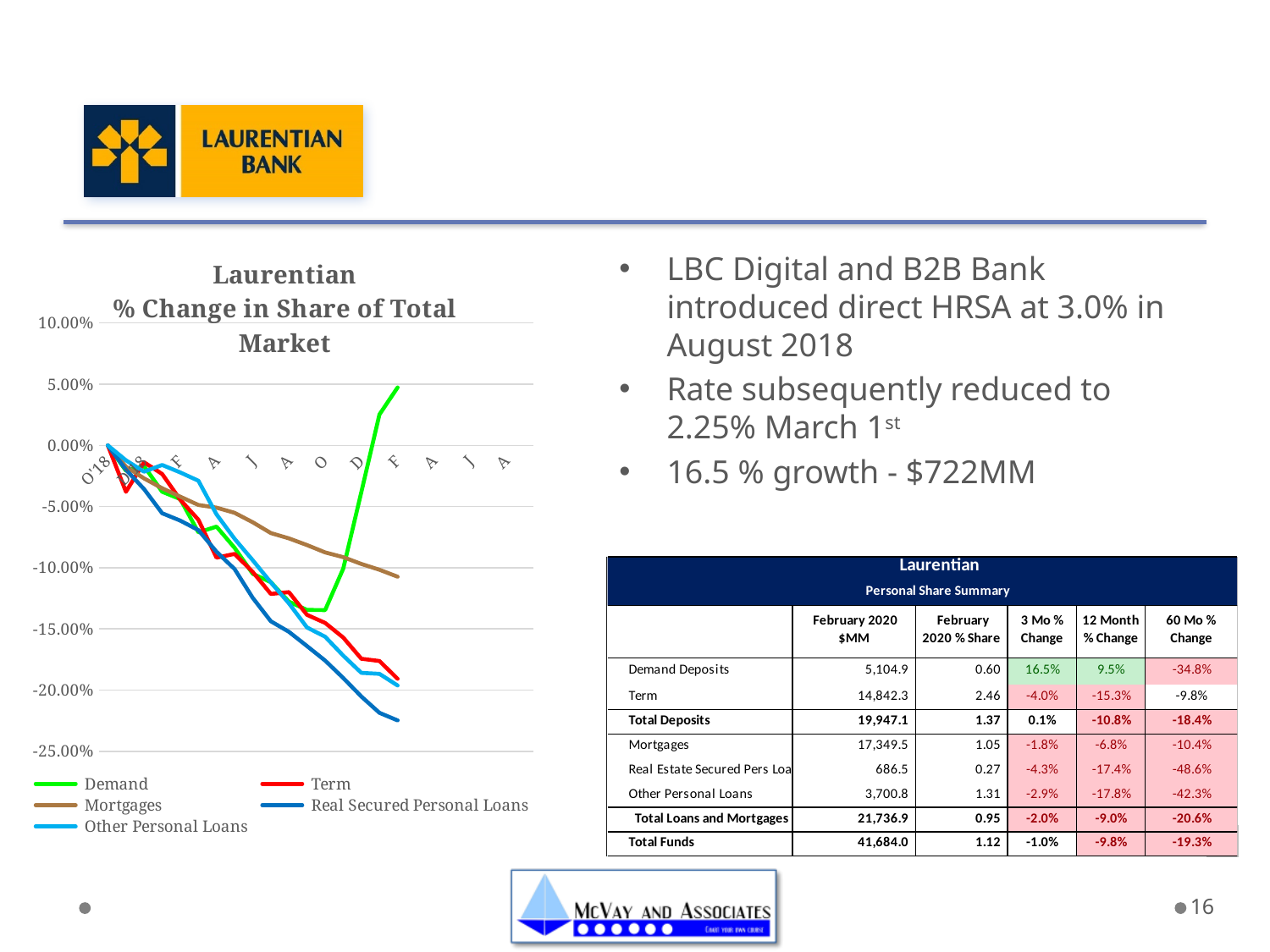
Which series has the highest value at the right end of the chart? Demand Is the final value of the Demand line greater or less than 0.00%? greater Is the final value of the Mortgages line greater or less than -5.00%? less Is the final value of the Real Secured Personal Loans line greater or less than -20.00%? less What kind of chart is shown on the slide? line chart What colour is the Demand line in the chart? green What is the title of the chart? Laurentian % Change in Share of Total Market How many series does the chart's legend list? 5 Does the Mortgages line rise or fall along the x axis? fall At the right end of the chart, which is higher: the Mortgages line or the Term line? Mortgages Which series has the lowest value at the right end of the chart? Real Secured Personal Loans